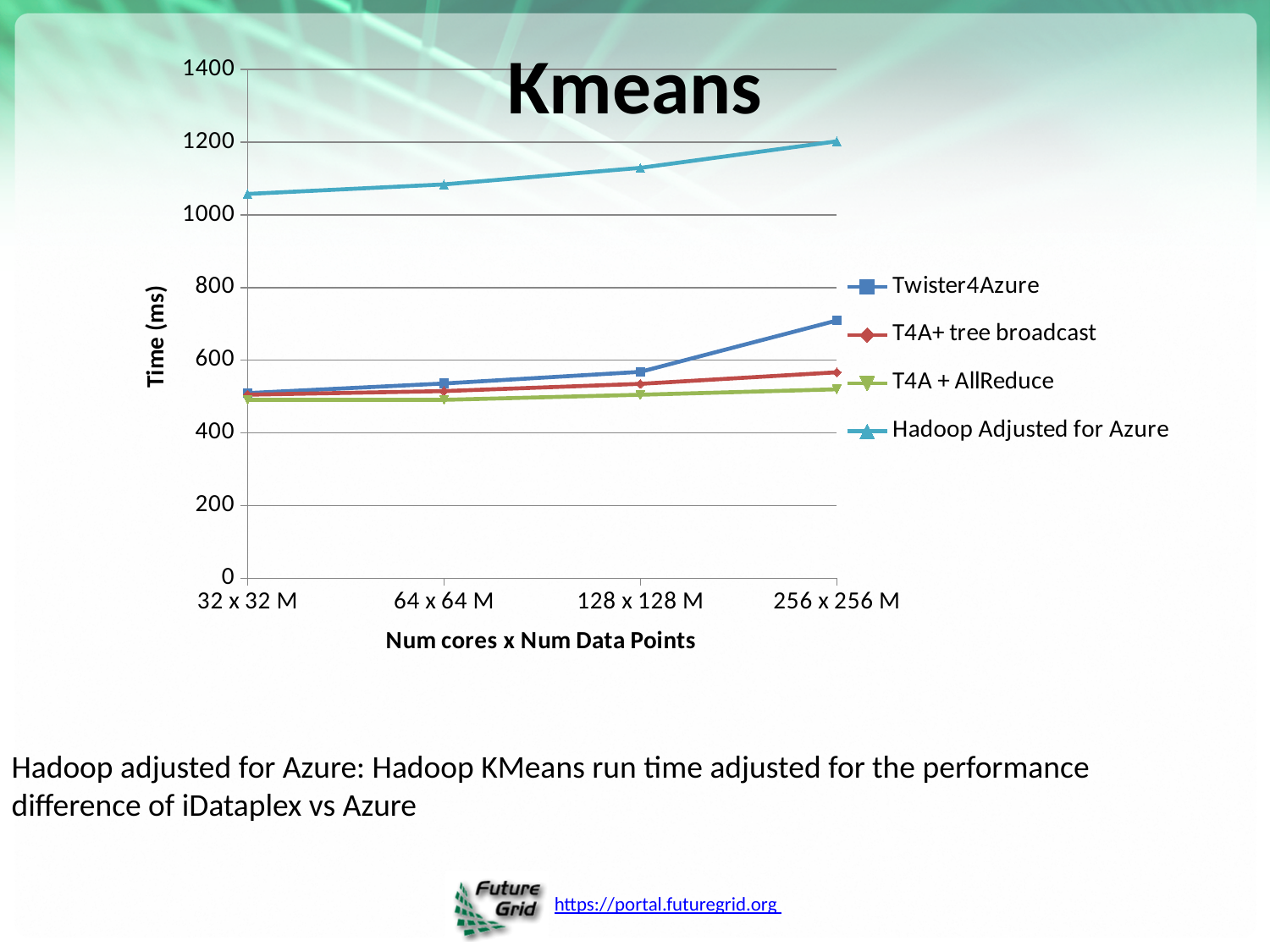
Which series has the lowest value at 256 x 256 M? T4A + AllReduce At 256 x 256 M, which is larger: Twister4Azure or T4A+ tree broadcast? Twister4Azure What is the title of the chart? Kmeans How many series does the legend list? 4 Is the value for Twister4Azure at 256 x 256 M greater or less than 600? greater Does the Hadoop Adjusted for Azure series rise or fall from 32 x 32 M to 256 x 256 M? rise How many categories are shown on the x axis? 4 Is the value for T4A + AllReduce at 256 x 256 M greater or less than 600? less What type of chart is shown on the slide? line chart Is the value for Hadoop Adjusted for Azure at 32 x 32 M greater or less than 1000? greater What is the label of the y axis? Time (ms) Which series has the highest value at 256 x 256 M? Hadoop Adjusted for Azure